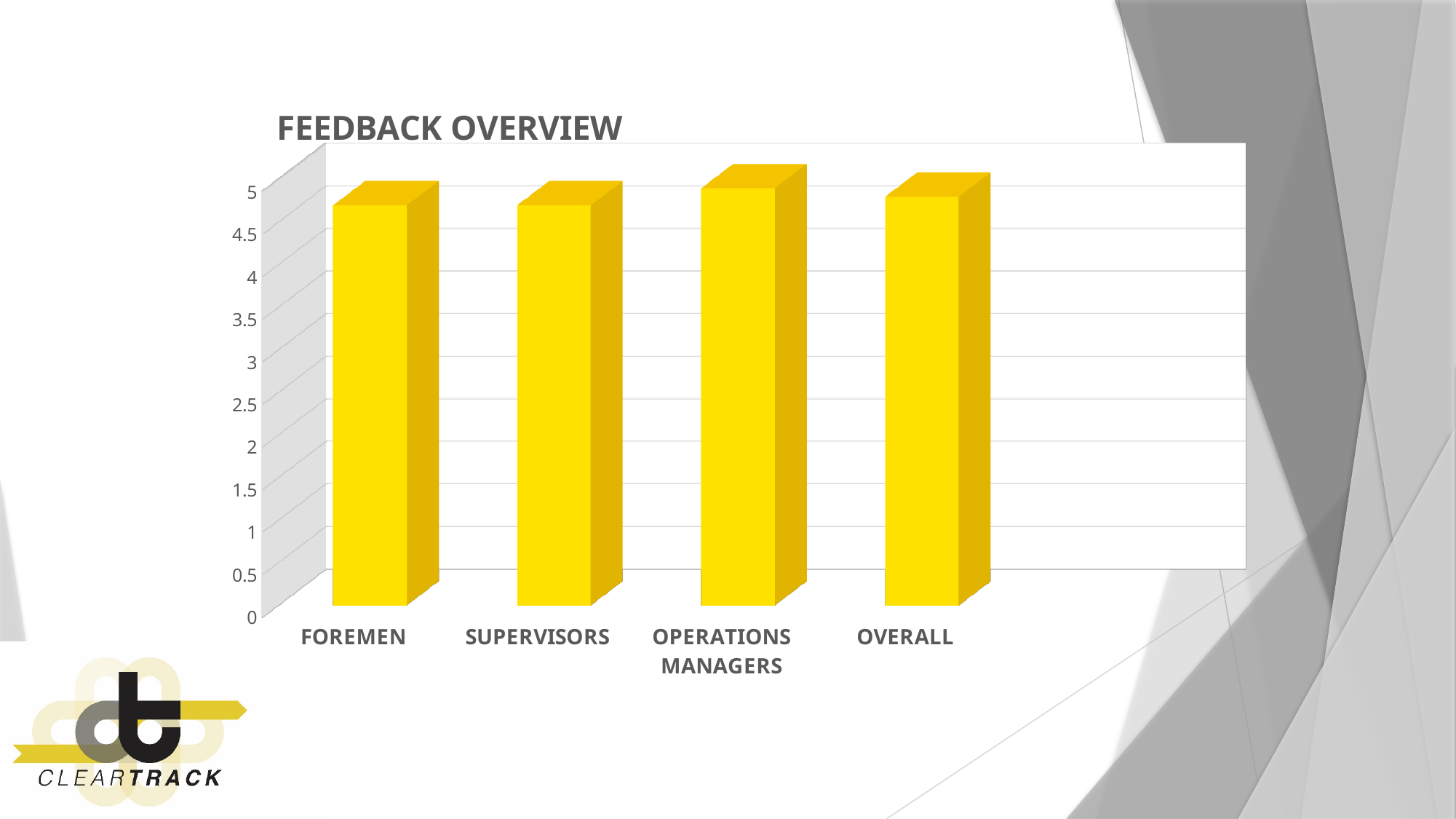
Is the value for FOREMEN greater or less than 4.5? greater Is the value for OVERALL greater or less than 4.5? greater Which is larger, the value for OPERATIONS MANAGERS or the value for FOREMEN? OPERATIONS MANAGERS How many categories are shown on the x axis of the chart? 4 Which is larger, the value for OPERATIONS MANAGERS or the value for SUPERVISORS? OPERATIONS MANAGERS What is the highest value shown on the vertical axis of the chart? 5 What is the title of the chart? FEEDBACK OVERVIEW What colour are the bars in the chart? Yellow Is the value for SUPERVISORS greater or less than 4? greater Which category has the highest value in the chart? OPERATIONS MANAGERS What kind of chart is shown on the slide? Bar chart